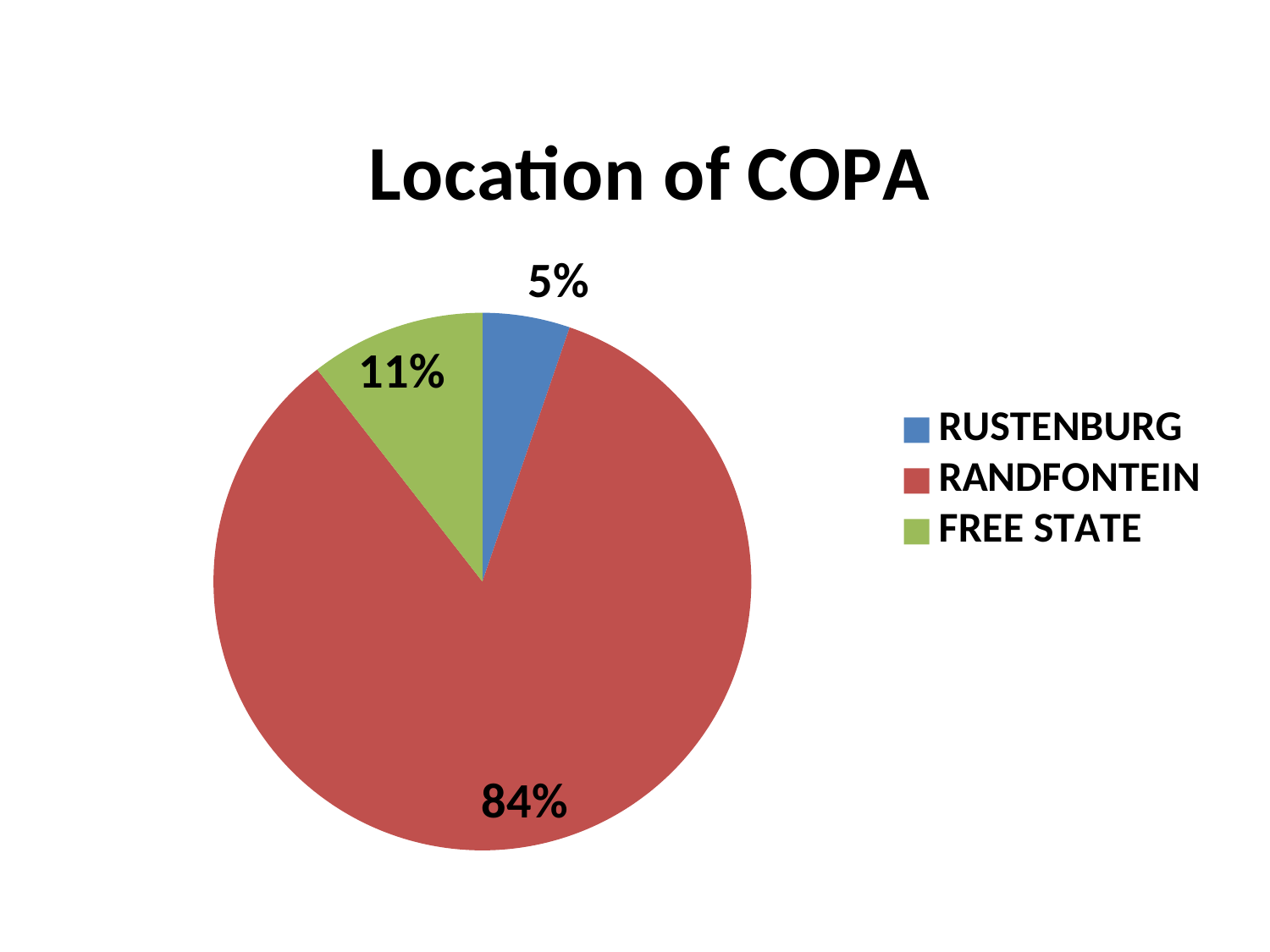
What share of the pie does RUSTENBURG account for? 5% What share of the pie does FREE STATE account for? 11% Which location has the largest slice of the pie? RANDFONTEIN Which is larger, the share for FREE STATE or the share for RUSTENBURG? FREE STATE Which colour represents FREE STATE in the legend? Green What is the title of the chart? Location of COPA What is the difference in percentage points between FREE STATE and RUSTENBURG? 6 What share of the pie does RANDFONTEIN account for? 84% Which location has the smallest slice of the pie? RUSTENBURG What kind of chart is shown on the slide? Pie chart How many locations are shown in the pie chart? 3 What is the difference in percentage points between RANDFONTEIN and FREE STATE? 73